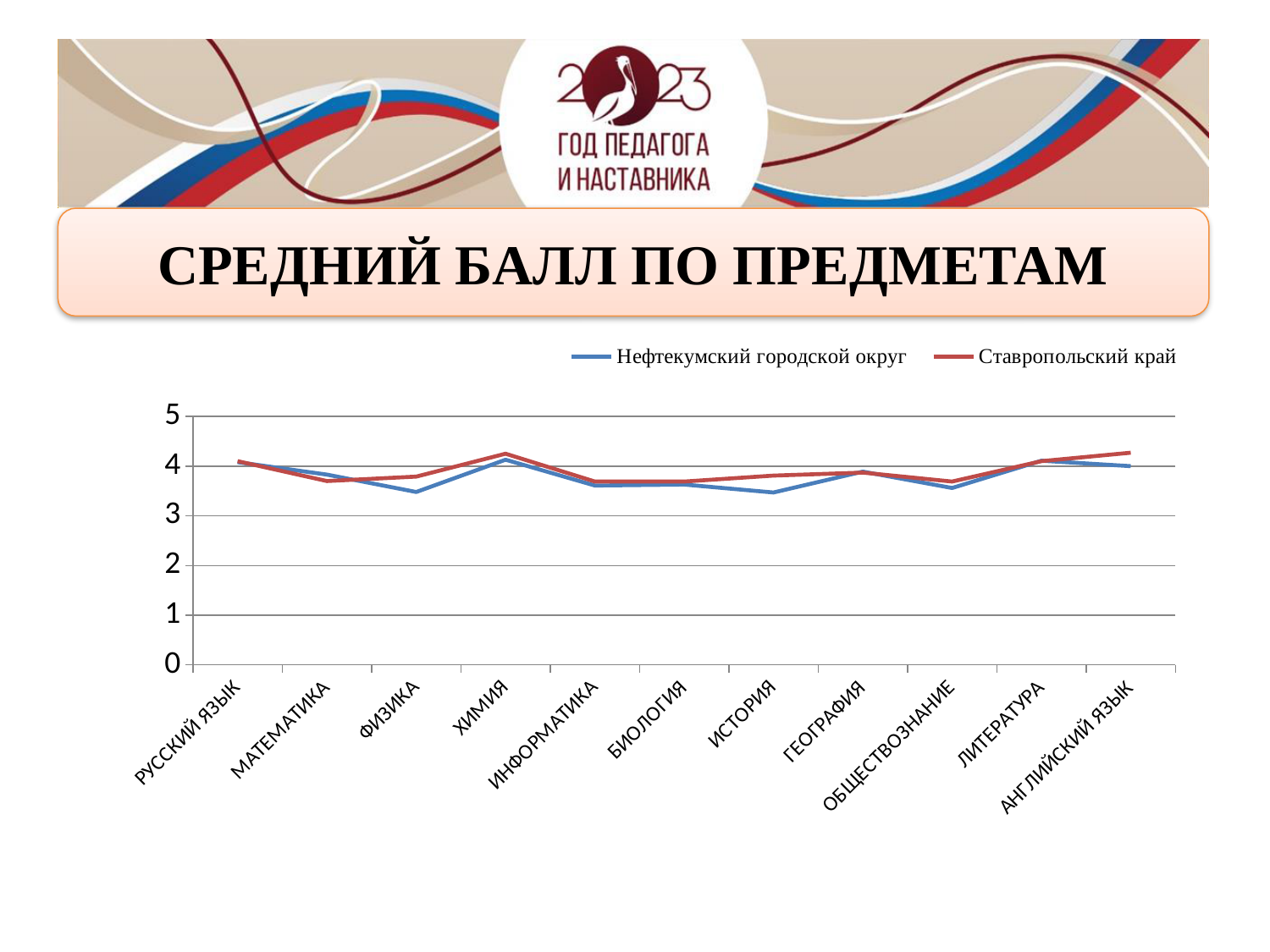
Is the value for Химия for Ставропольский край greater or less than 4? greater How many series does the legend list? 2 What is the title of the slide above the chart? СРЕДНИЙ БАЛЛ ПО ПРЕДМЕТАМ How many subjects are plotted along the x axis? 11 For Английский язык, which series has the higher value: Нефтекумский городской округ or Ставропольский край? Ставропольский край Is the value for История for Нефтекумский городской округ greater or less than 3? greater Is the value for Физика for Нефтекумский городской округ greater or less than 4? less What kind of chart is shown on the slide? line chart For История, which series has the higher value: Нефтекумский городской округ or Ставропольский край? Ставропольский край For Физика, which series has the higher value: Нефтекумский городской округ or Ставропольский край? Ставропольский край Which series is drawn with the red line? Ставропольский край